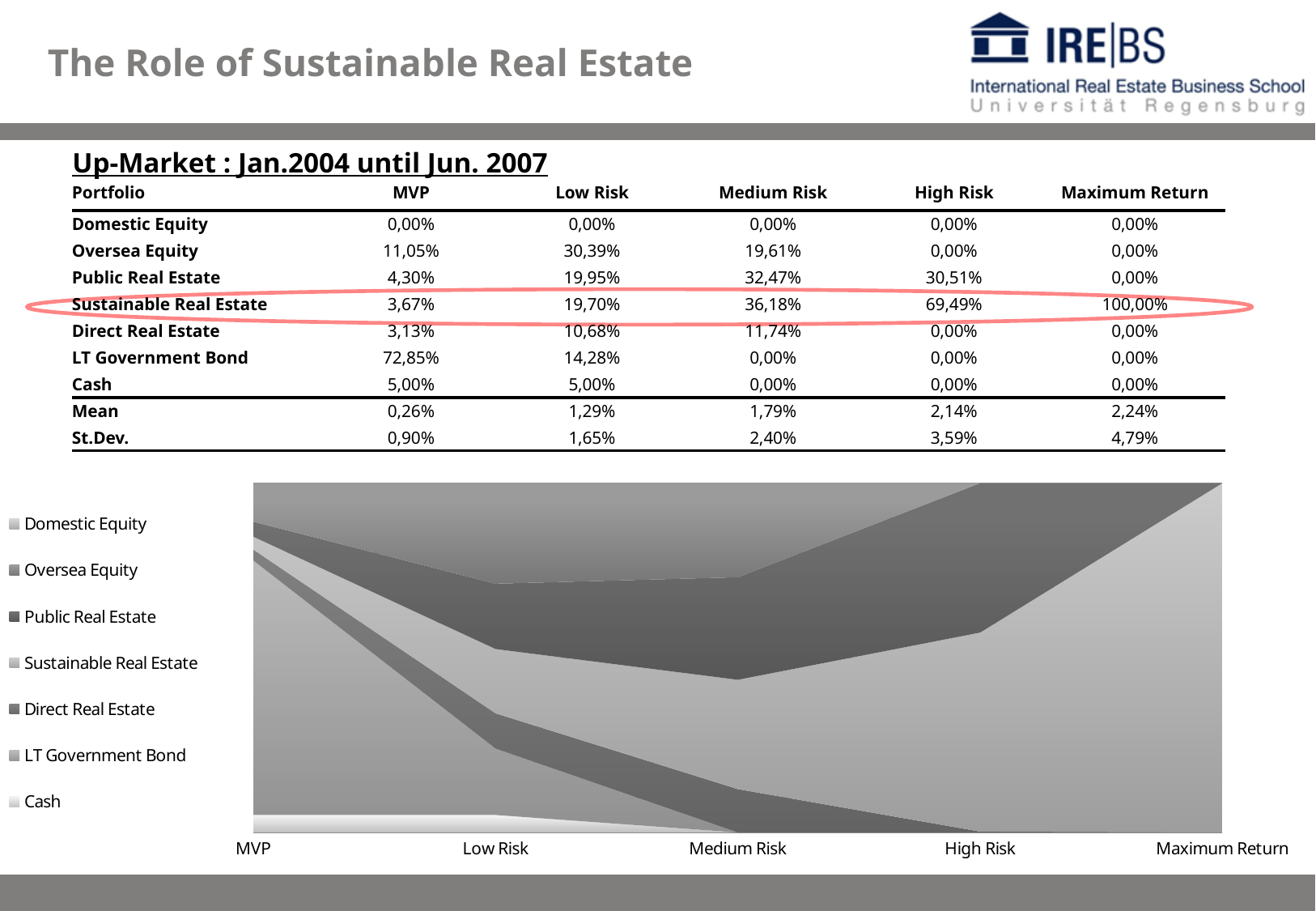
Which is larger in the Low Risk portfolio: Public Real Estate or Sustainable Real Estate? Public Real Estate Which row of the table is circled in red? Sustainable Real Estate How many series does the chart's legend list? 7 Which asset class has the largest share in the High Risk portfolio? Sustainable Real Estate What is the difference between the Sustainable Real Estate share in the High Risk portfolio and in the Medium Risk portfolio? 33,31% Which portfolio has the highest Oversea Equity share? Low Risk What is the Sustainable Real Estate share in the Maximum Return portfolio? 100,00% What is the LT Government Bond share in the MVP portfolio? 72,85% How many categories are shown along the x axis of the chart? 5 What kind of chart is shown at the bottom of the slide? Stacked area chart What is the Public Real Estate share in the Medium Risk portfolio? 32,47% Does the Sustainable Real Estate share rise or fall from MVP to Maximum Return? Rise